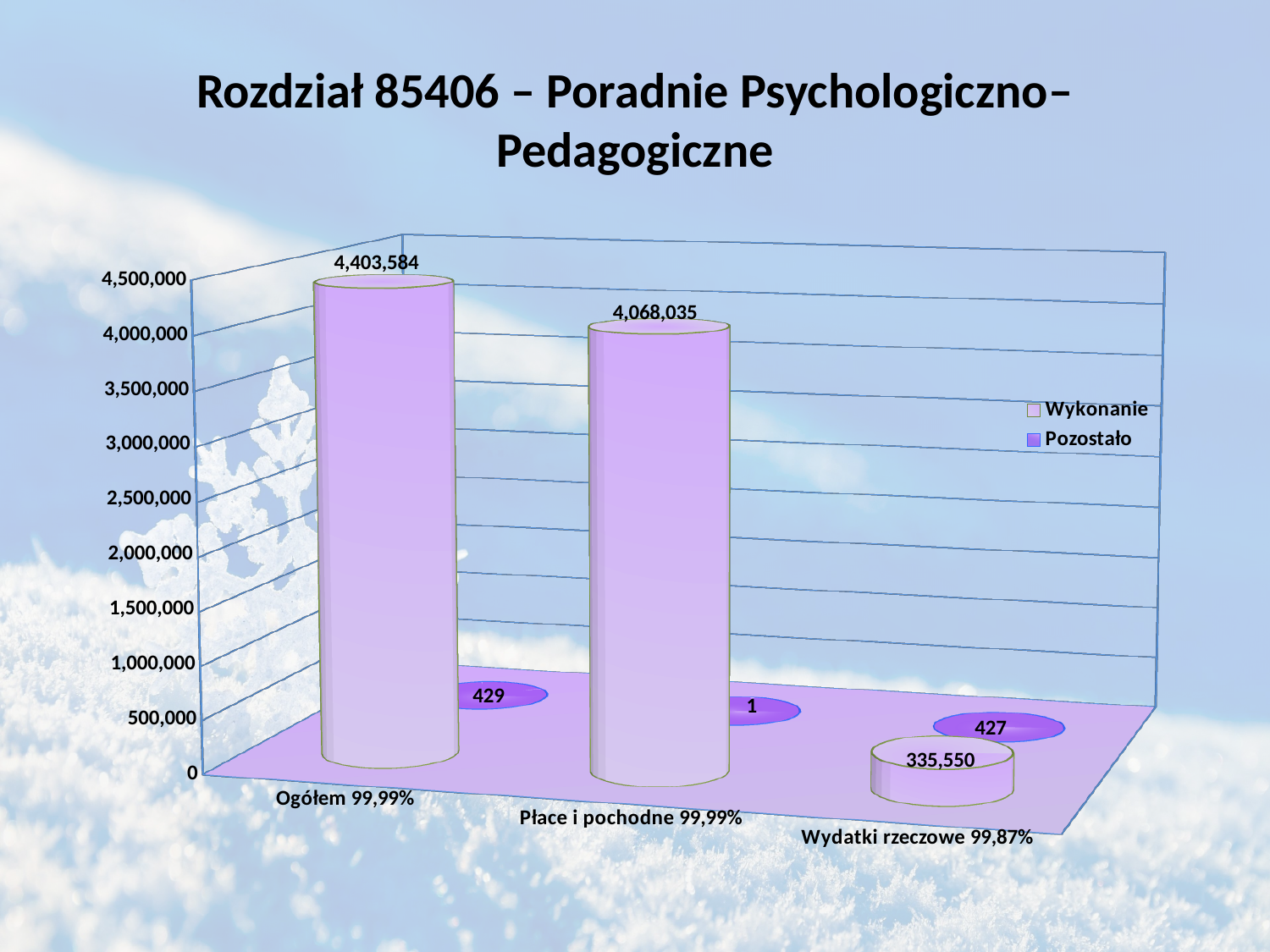
Which category has the lowest Pozostało value? Płace i pochodne 99,99% What is the Pozostało value for Ogółem 99,99%? 429 How many categories are shown on the x axis? 3 What is the Wykonanie value for Ogółem 99,99%? 4,403,584 What kind of chart is shown on the slide? Bar chart What is the Wykonanie value for Płace i pochodne 99,99%? 4,068,035 How many series does the legend list? 2 What is the Pozostało value for Płace i pochodne 99,99%? 1 Which category has the highest Wykonanie value? Ogółem 99,99% What is the Wykonanie value for Wydatki rzeczowe 99,87%? 335,550 What is the Pozostało value for Wydatki rzeczowe 99,87%? 427 What is the difference between the Wykonanie values for Ogółem 99,99% and Płace i pochodne 99,99%? 335,549